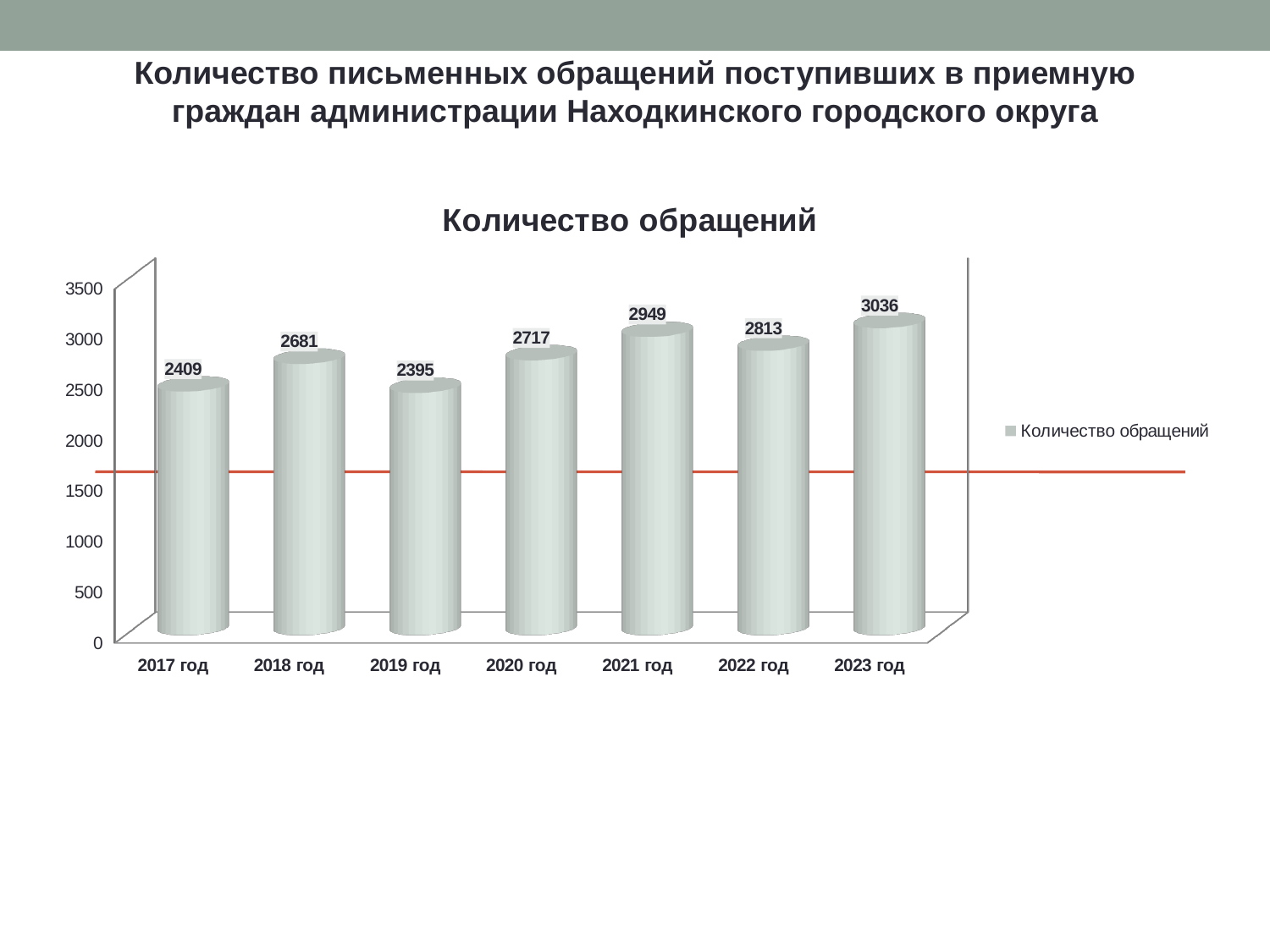
How many years are shown on the x axis? 7 Which year has the highest number of обращений? 2023 год What is the value for 2017 год? 2409 Which year has the lowest number of обращений? 2019 год How many series does the legend list? 1 Which is larger, the value for 2018 год or the value for 2019 год? 2018 год Is the value for 2021 год greater or less than 2500? greater What is the value for 2020 год? 2717 What is the difference between the values for 2023 год and 2017 год? 627 What kind of chart is shown on the slide? bar chart What is the difference between the values for 2021 год and 2022 год? 136 What is the value for 2022 год? 2813